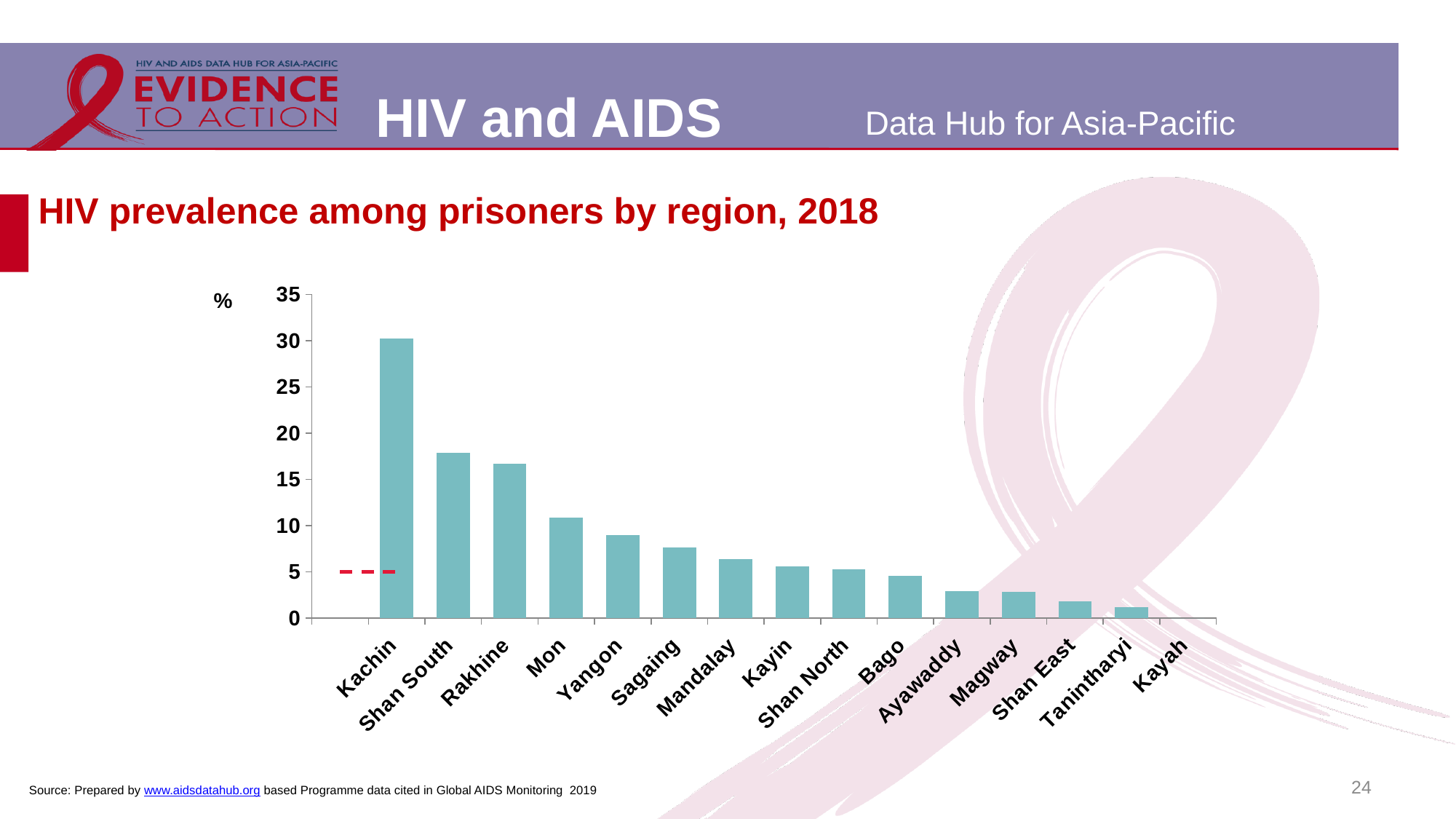
What is the title of the chart? HIV prevalence among prisoners by region, 2018 Is the value for Kachin greater or less than 25? greater Is the value for Shan South greater or less than 15? greater How many regions are shown on the x axis of the chart? 15 Which region has the highest HIV prevalence among prisoners? Kachin Which region has the lowest HIV prevalence among prisoners? Kayah Is the value for Shan East greater or less than 5? less What kind of chart is shown on the slide? bar chart Do the values rise or fall moving from left to right along the x axis? fall Which region has a higher HIV prevalence among prisoners, Kachin or Shan South? Kachin